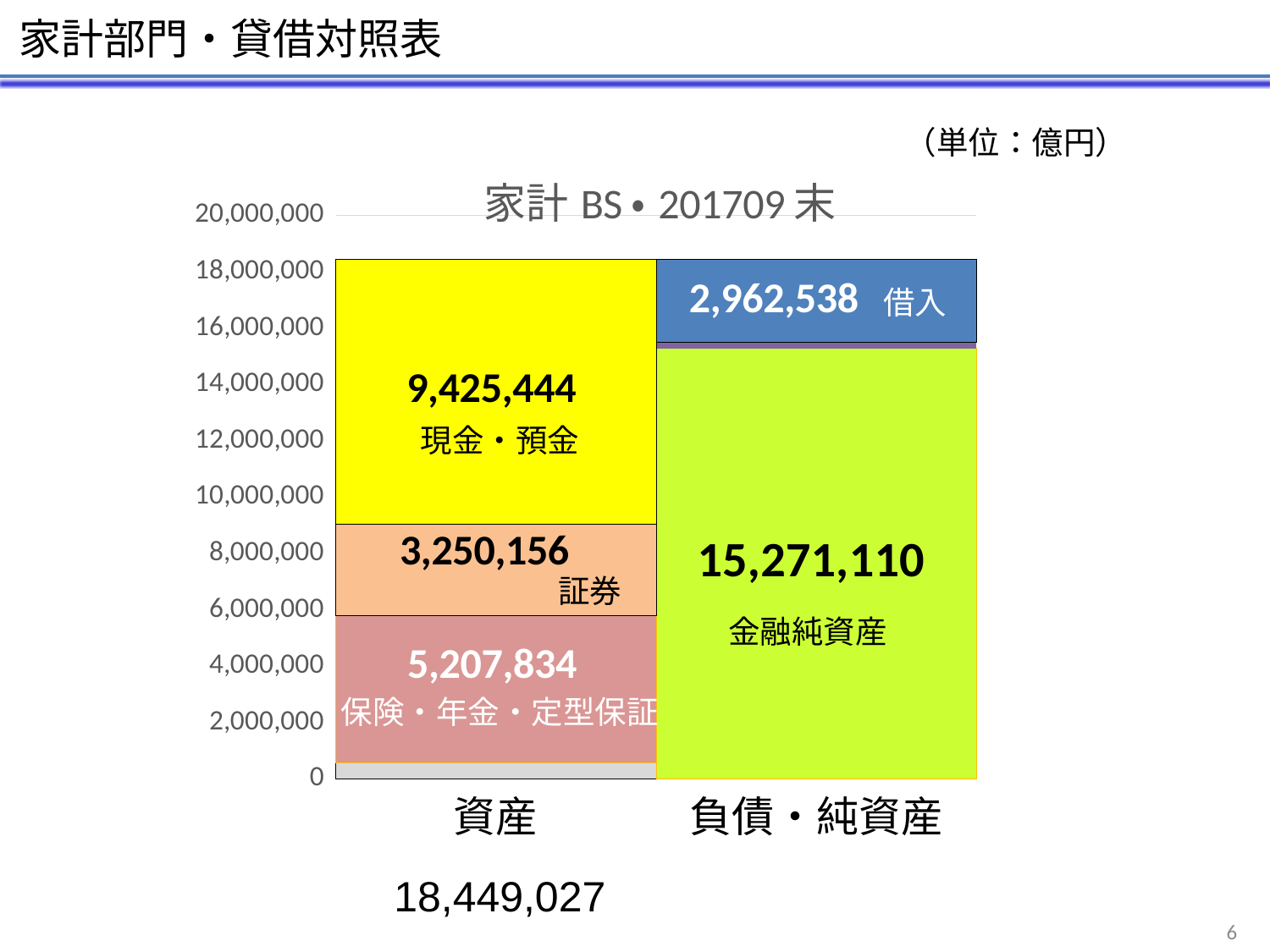
What is the difference between 現金・預金 and 証券? 6,175,288 Which labelled segment has the largest value? 金融純資産 Which is larger, 保険・年金・定型保証 or 証券? 保険・年金・定型保証 What is the total of the 資産 bar as printed on the slide? 18,449,027 What is the title of the chart? 家計 BS・201709 末 What is the value of the 金融純資産 segment? 15,271,110 What is the value of the 保険・年金・定型保証 segment? 5,207,834 What is the difference between 金融純資産 and 借入? 12,308,572 What kind of chart is shown? Stacked bar chart What is the value of the 現金・預金 segment in the 資産 bar? 9,425,444 What is the value of the 借入 segment in the 負債・純資産 bar? 2,962,538 What is the value of the 証券 segment? 3,250,156